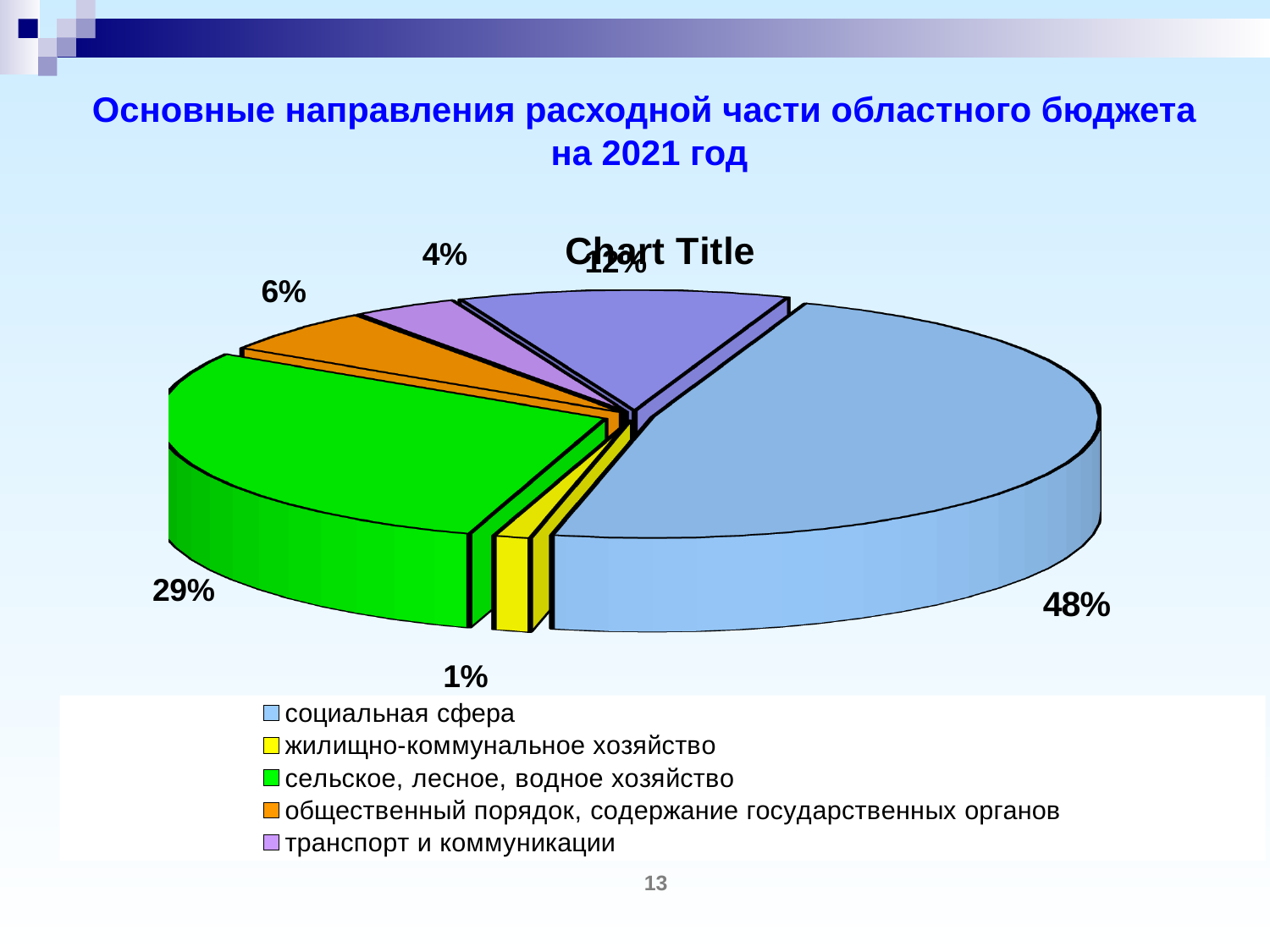
What kind of chart is shown on the slide? pie chart What colour is the slice for "сельское, лесное, водное хозяйство"? green What share of the pie does "жилищно-коммунальное хозяйство" have? 1% What share of the pie does "транспорт и коммуникации" have? 4% How many entries does the legend list? 5 What share of the pie does "общественный порядок, содержание государственных органов" have? 6% Which is larger, the share for "общественный порядок, содержание государственных органов" or the share for "транспорт и коммуникации"? общественный порядок, содержание государственных органов What is the difference in percentage points between "социальная сфера" and "сельское, лесное, водное хозяйство"? 19 What share of the pie does "сельское, лесное, водное хозяйство" have? 29% What share of the pie does "социальная сфера" have? 48% Which category has the smallest share of the pie? жилищно-коммунальное хозяйство Which category has the largest share of the pie? социальная сфера